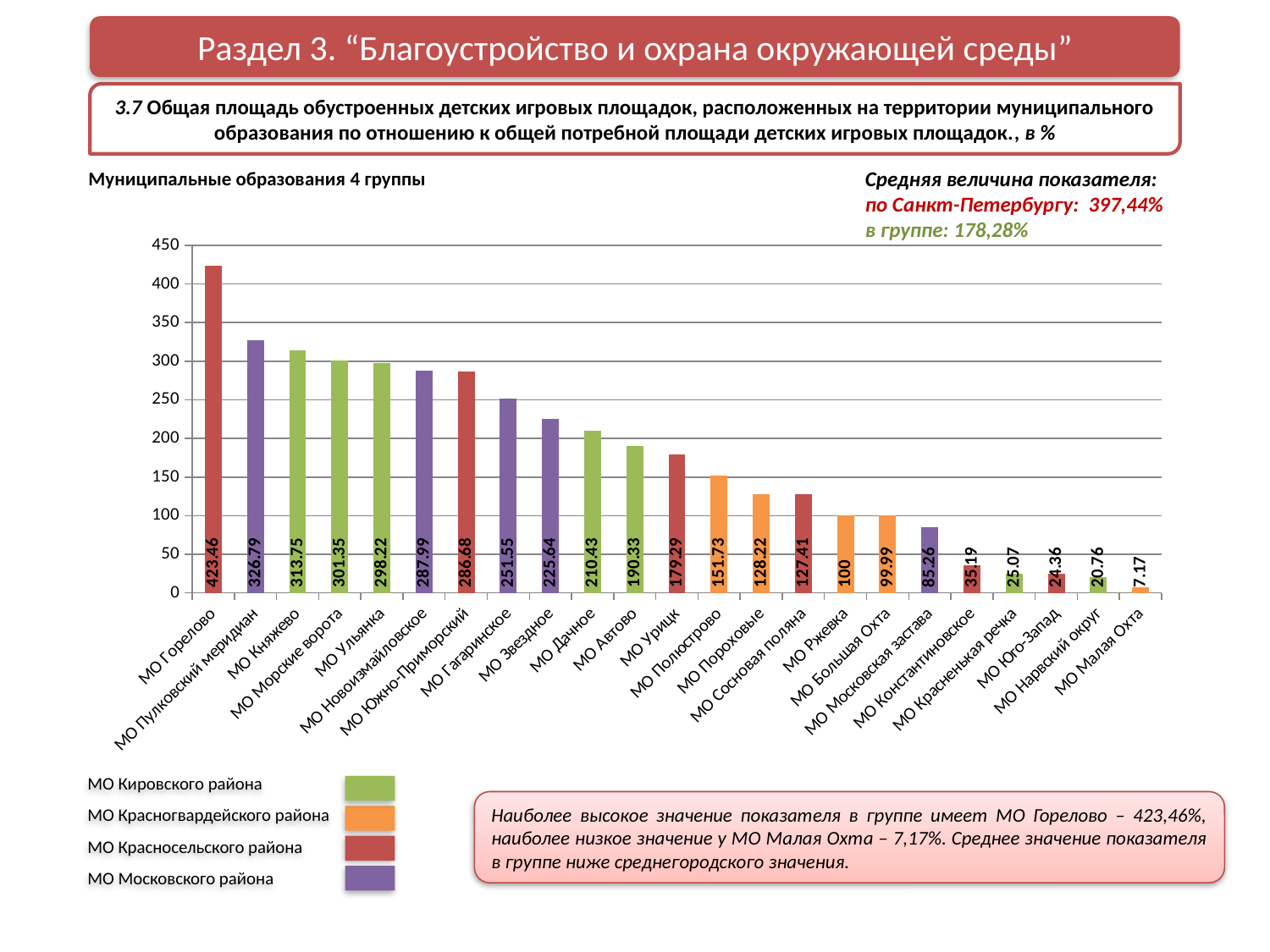
How many entries does the legend list? 4 Which municipality has the lowest value on the chart? МО Малая Охта What kind of chart is shown on the slide? bar chart Is the value for МО Гагаринское greater or less than 250? greater What is the difference between the values for МО Горелово and МО Малая Охта? 416,29 Which is larger, the value for МО Княжево or the value for МО Ульянка? МО Княжево How many municipalities are shown on the chart? 23 Which municipality has the highest value on the chart? МО Горелово What is the value for МО Московская застава? 85,26 What is the difference between the values for МО Полюстрово and МО Пороховые? 23,51 What is the value for МО Горелово? 423,46 What is the value for МО Полюстрово? 151,73